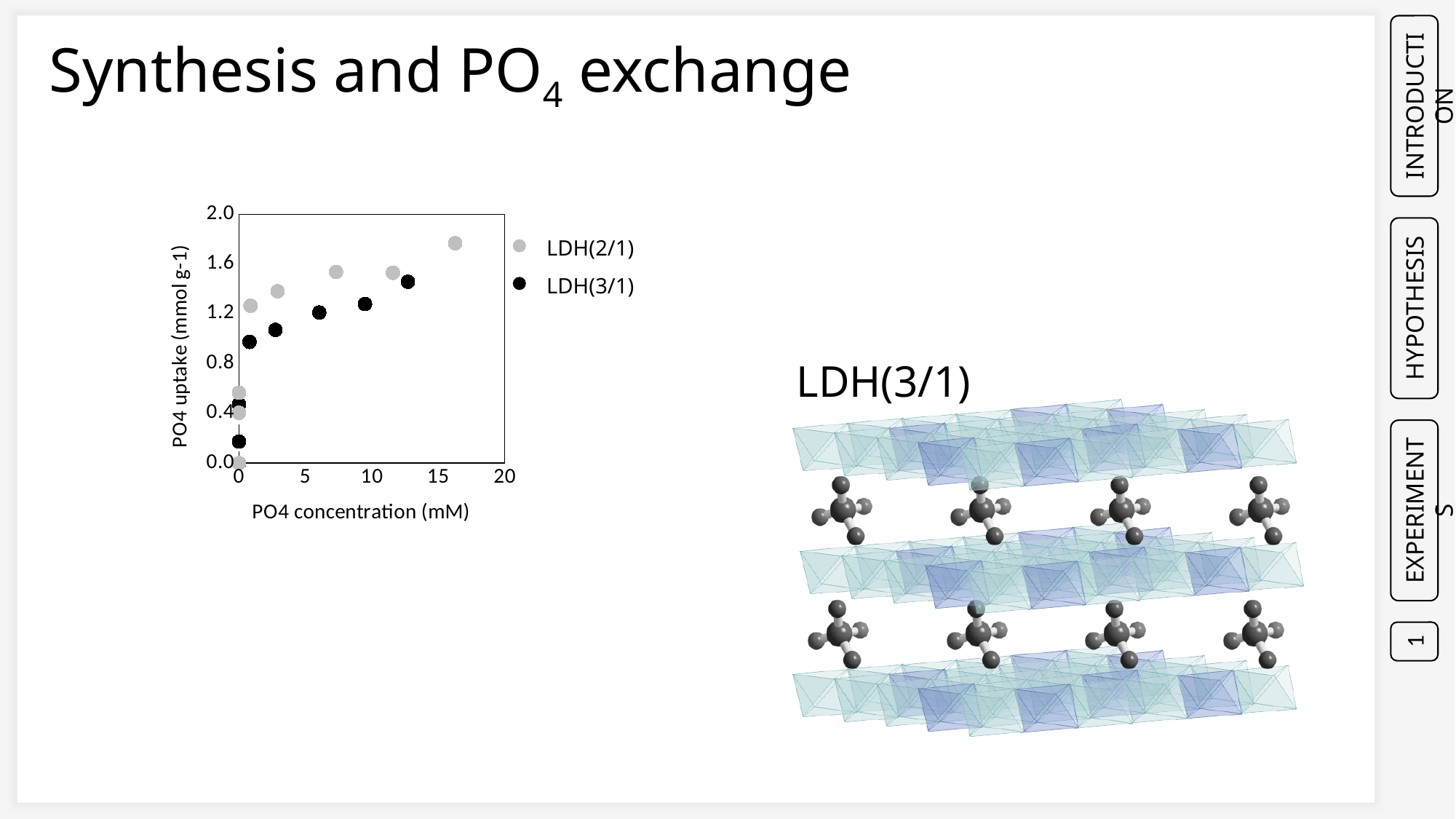
Is the PO4 uptake of the LDH(3/1) point at about 1 mM greater or less than 0.8? greater Is the PO4 uptake of the LDH(3/1) point at about 3 mM greater or less than 1.2? less Which series reaches the highest PO4 uptake on the chart? LDH(2/1) Is the PO4 uptake of the highest LDH(2/1) point (at about 16 mM) greater or less than 1.6? greater How many series does the chart's legend list? 2 Does PO4 uptake rise or fall as PO4 concentration increases along the x axis? rise At a PO4 concentration of about 1 mM, which series has the larger PO4 uptake, LDH(2/1) or LDH(3/1)? LDH(2/1) Which series is plotted with black markers, LDH(2/1) or LDH(3/1)? LDH(3/1) What are the two series named in the chart's legend? LDH(2/1) and LDH(3/1) What is the label of the chart's x axis? PO4 concentration (mM) What kind of chart is shown on the slide? scatter chart